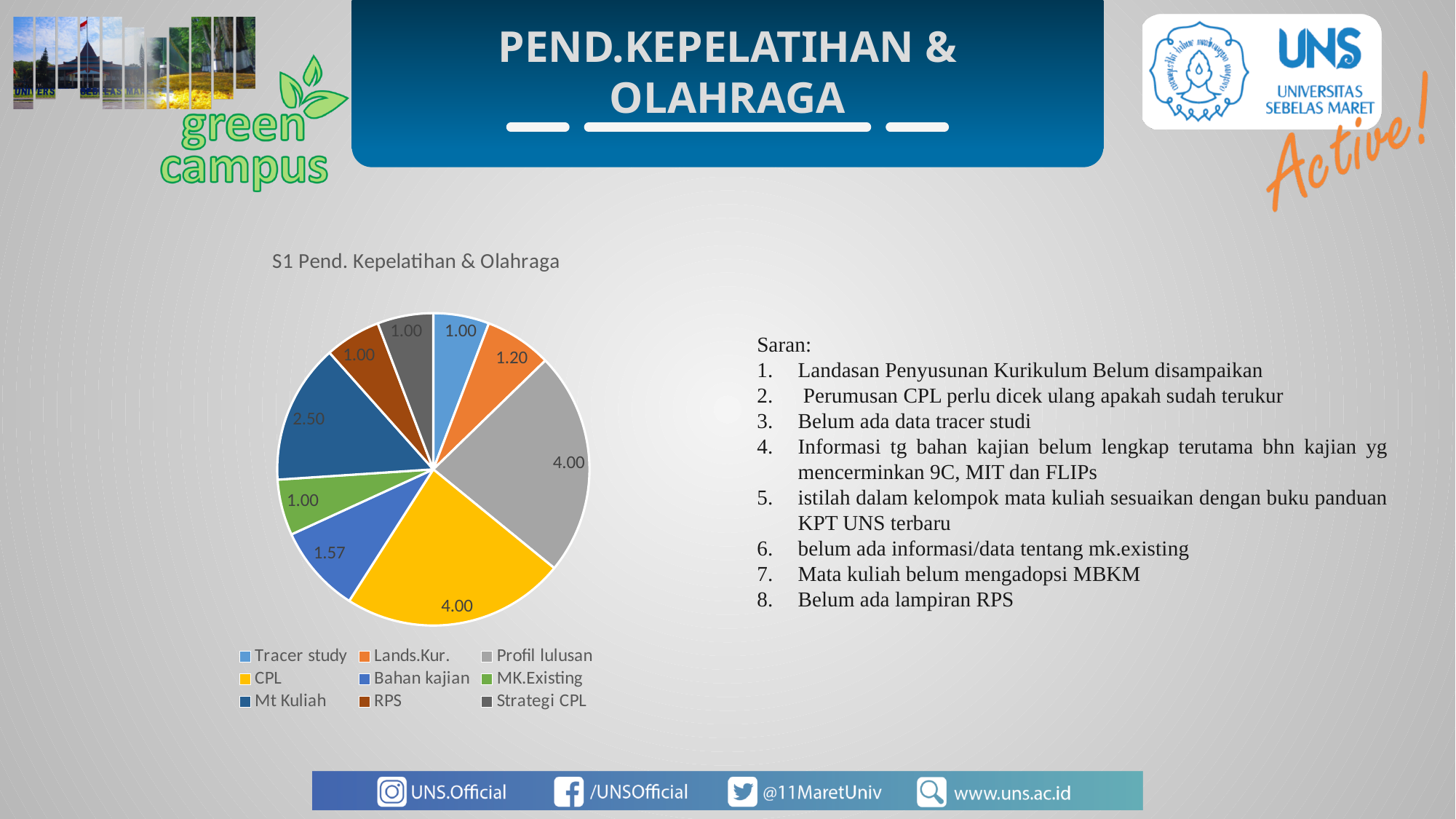
What is the value for Profil lulusan in the pie chart? 4.00 What is the title of the pie chart? S1 Pend. Kepelatihan & Olahraga What is the value for Lands.Kur. in the pie chart? 1.20 What type of chart is shown on the slide? pie chart What is the value for Mt Kuliah in the pie chart? 2.50 What is the difference between the values for Mt Kuliah and Bahan kajian? 0.93 What is the difference between the values for Lands.Kur. and Tracer study? 0.20 Which legend entry is shown in yellow in the pie chart? CPL Which is larger in the pie chart, Mt Kuliah or Bahan kajian? Mt Kuliah How many slices does the pie chart have? 9 What is the value for Bahan kajian in the pie chart? 1.57 What is the value for Tracer study in the pie chart? 1.00